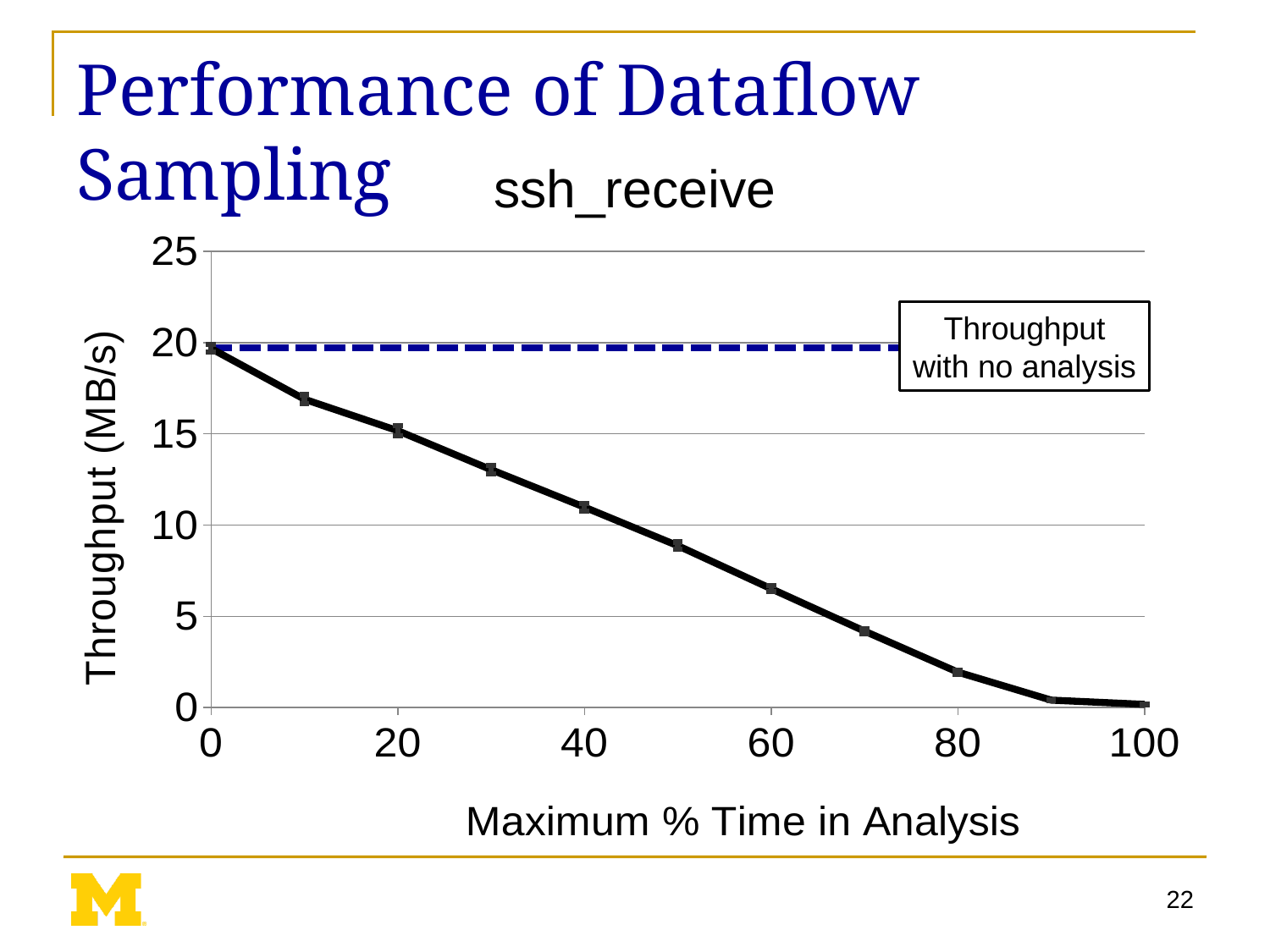
Is the throughput at 60% Maximum Time in Analysis greater or less than 5? greater What is the title of the chart? ssh_receive Is the throughput at 50% Maximum Time in Analysis greater or less than 10? less What is the label of the y axis? Throughput (MB/s) How many data points are plotted on the solid line? 11 Does throughput rise or fall as Maximum % Time in Analysis increases? fall Is the throughput at 30% Maximum Time in Analysis greater or less than 15? less What kind of chart is shown on the slide? line chart At which Maximum % Time in Analysis value is throughput highest? 0 Which has higher throughput: 20% or 60% Maximum Time in Analysis? 20%